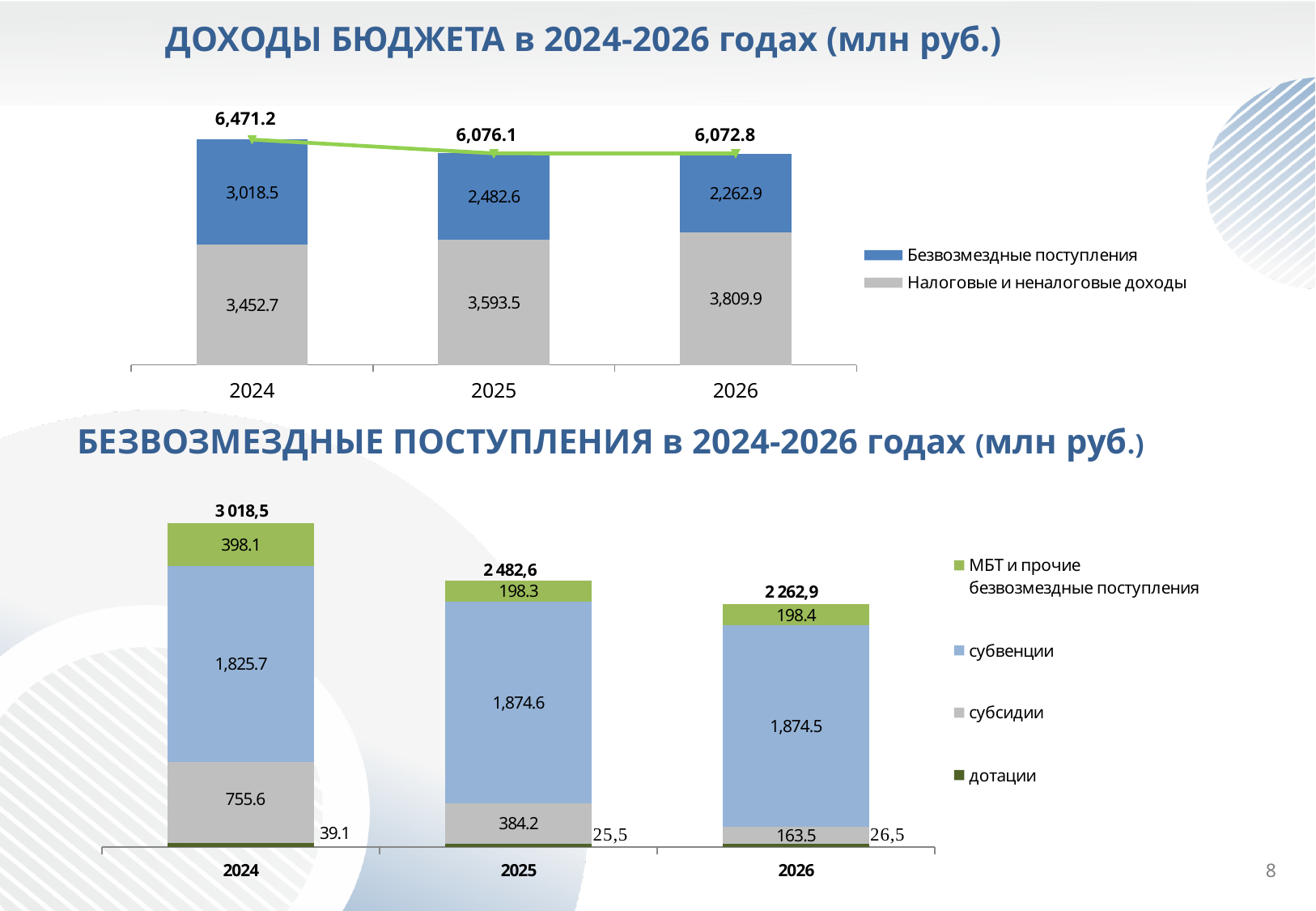
In the chart 'ДОХОДЫ БЮДЖЕТА в 2024-2026 годах', what is the total shown above the 2025 bar? 6,076.1 In the chart 'БЕЗВОЗМЕЗДНЫЕ ПОСТУПЛЕНИЯ в 2024-2026 годах', which is larger: 'субвенции' in 2024 or 'субвенции' in 2025? 2025 In the chart 'БЕЗВОЗМЕЗДНЫЕ ПОСТУПЛЕНИЯ в 2024-2026 годах', what is the value of 'дотации' for 2024? 39.1 In the chart 'ДОХОДЫ БЮДЖЕТА в 2024-2026 годах', what is the difference between 'Безвозмездные поступления' in 2024 and in 2025? 535.9 How many series does the legend of the chart 'ДОХОДЫ БЮДЖЕТА в 2024-2026 годах' list? 2 In the chart 'ДОХОДЫ БЮДЖЕТА в 2024-2026 годах', which year has the highest total? 2024 In the chart 'ДОХОДЫ БЮДЖЕТА в 2024-2026 годах', what is the value of 'Налоговые и неналоговые доходы' for 2026? 3,809.9 What type of chart is 'БЕЗВОЗМЕЗДНЫЕ ПОСТУПЛЕНИЯ в 2024-2026 годах'? stacked bar chart In the chart 'БЕЗВОЗМЕЗДНЫЕ ПОСТУПЛЕНИЯ в 2024-2026 годах', what is the value of 'субсидии' for 2025? 384.2 In the chart 'ДОХОДЫ БЮДЖЕТА в 2024-2026 годах', what is the value of 'Безвозмездные поступления' for 2024? 3,018.5 In the chart 'БЕЗВОЗМЕЗДНЫЕ ПОСТУПЛЕНИЯ в 2024-2026 годах', which year has the lowest value of 'субсидии'? 2026 In the chart 'ДОХОДЫ БЮДЖЕТА в 2024-2026 годах', do the values of 'Налоговые и неналоговые доходы' rise or fall from 2024 to 2026? rise